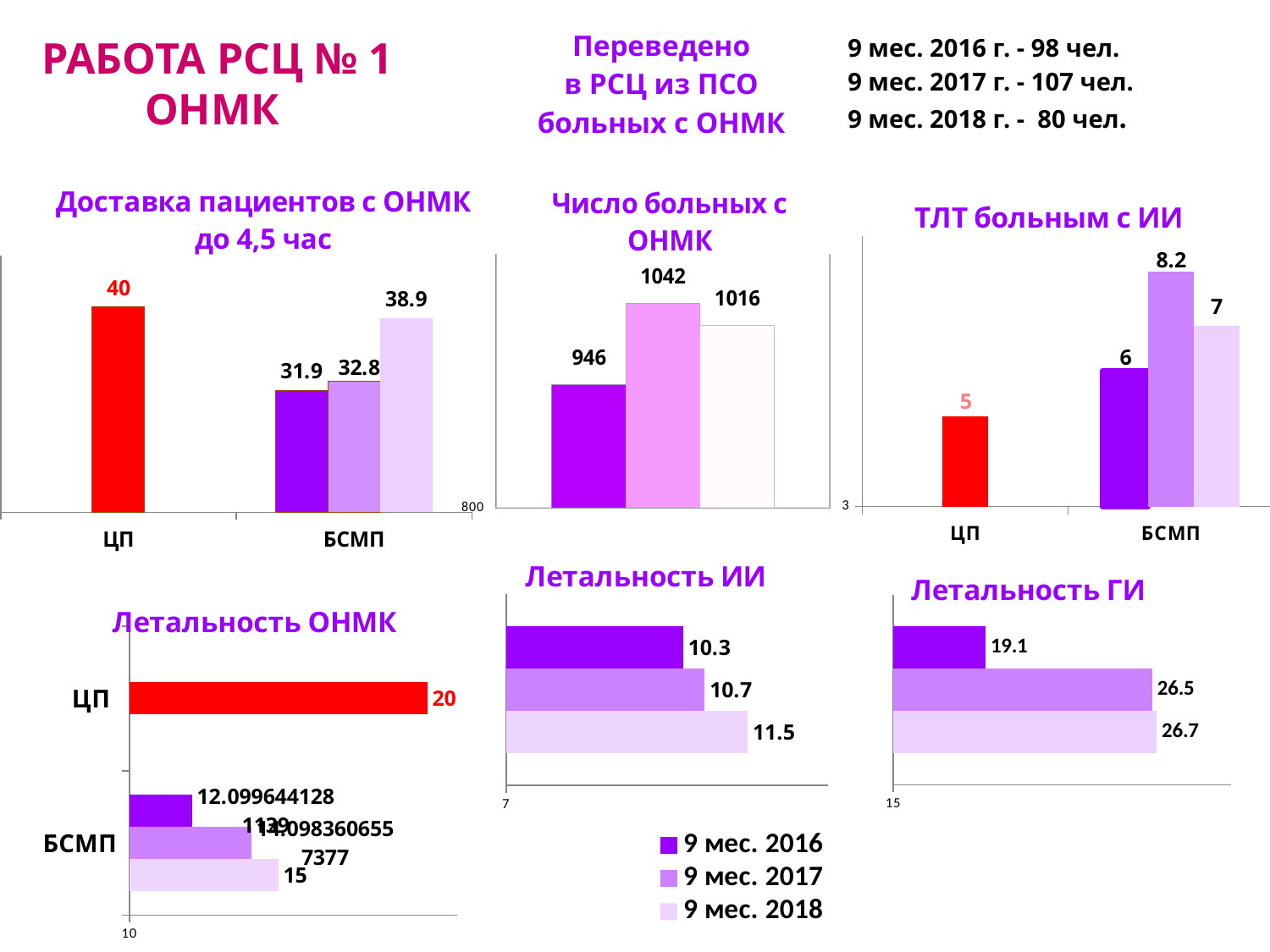
How many series does the shared legend at the bottom of the slide list? 3 In the chart 'ТЛТ больным с ИИ', what is the value for БСМП in 9 мес. 2017? 8.2 In the chart 'Число больных с ОНМК', what is the value for 9 мес. 2017? 1042 In the chart 'Доставка пациентов с ОНМК до 4,5 час', what is the value for БСМП in 9 мес. 2018? 38.9 In the chart 'Число больных с ОНМК', which period has the lowest value? 9 мес. 2016 In the chart 'Летальность ОНМК', what is the value for ЦП? 20 In the chart 'Доставка пациентов с ОНМК до 4,5 час', which is larger: the value for ЦП or the value for БСМП in 9 мес. 2018? ЦП In the chart 'Летальность ИИ', what is the value for 9 мес. 2018? 11.5 In the chart 'Летальность ГИ', what is the difference between the 2018 and 2016 values? 7.6 In the chart 'ТЛТ больным с ИИ', what is the value for ЦП? 5 In the chart 'Число больных с ОНМК', what is the difference between the 2017 and 2016 values? 96 In the chart 'Летальность ИИ', do the values rise or fall from 2016 to 2018? rise